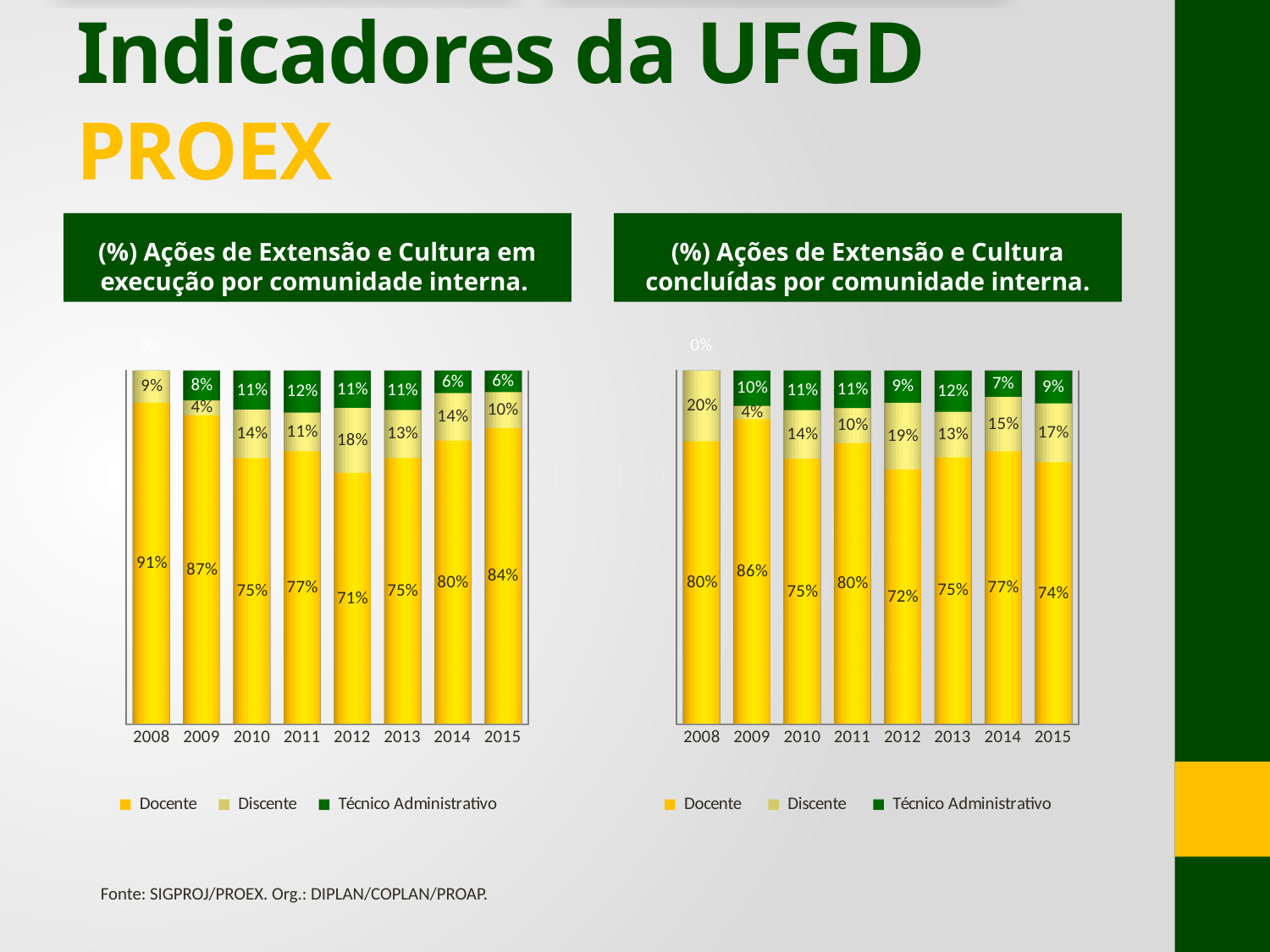
What kind of chart is the left chart (em execução)? Stacked bar chart In the left chart (em execução), what is the Discente value for 2012? 18% In the right chart (concluídas), which is larger, the Discente value for 2012 or for 2014? 2012 In the right chart (concluídas), what is the Docente value for 2009? 86% In the right chart (concluídas), which year has the highest Docente value? 2009 How many series does the legend of the right chart (concluídas) list? 3 Which series is shown in dark green in the legend of the right chart (concluídas)? Técnico Administrativo How many years are shown on the x axis of the left chart (em execução)? 8 In the left chart (em execução), what is the Docente value for 2008? 91% In the left chart (em execução), which year has the lowest Docente value? 2012 In the left chart (em execução), what is the difference between the Docente values for 2008 and 2012? 20% In the right chart (concluídas), what is the Técnico Administrativo value for 2013? 12%